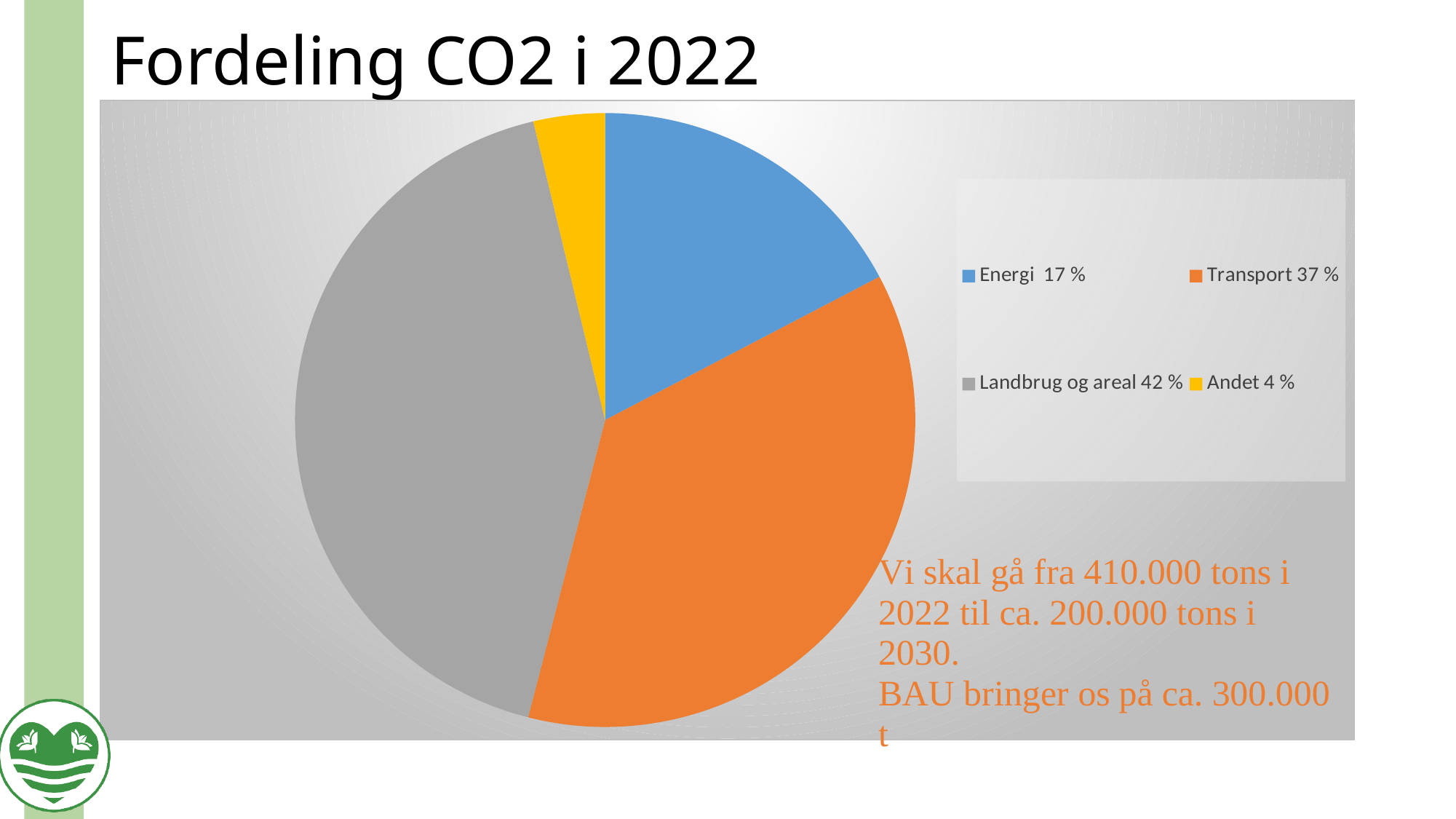
What share of CO2 does Andet account for in the pie chart? 4 % What share of CO2 does Energi account for in the pie chart? 17 % What share of CO2 does Transport account for in the pie chart? 37 % Which category has the largest slice of the pie chart? Landbrug og areal How many categories are shown in the pie chart? 4 What is the title of the slide containing the pie chart? Fordeling CO2 i 2022 Which category has the smallest slice of the pie chart? Andet What kind of chart is shown on the slide? pie chart Which is larger, the share for Energi or the share for Transport? Transport Which colour represents Transport in the pie chart? orange What is the difference in percentage points between Landbrug og areal and Transport? 5 %